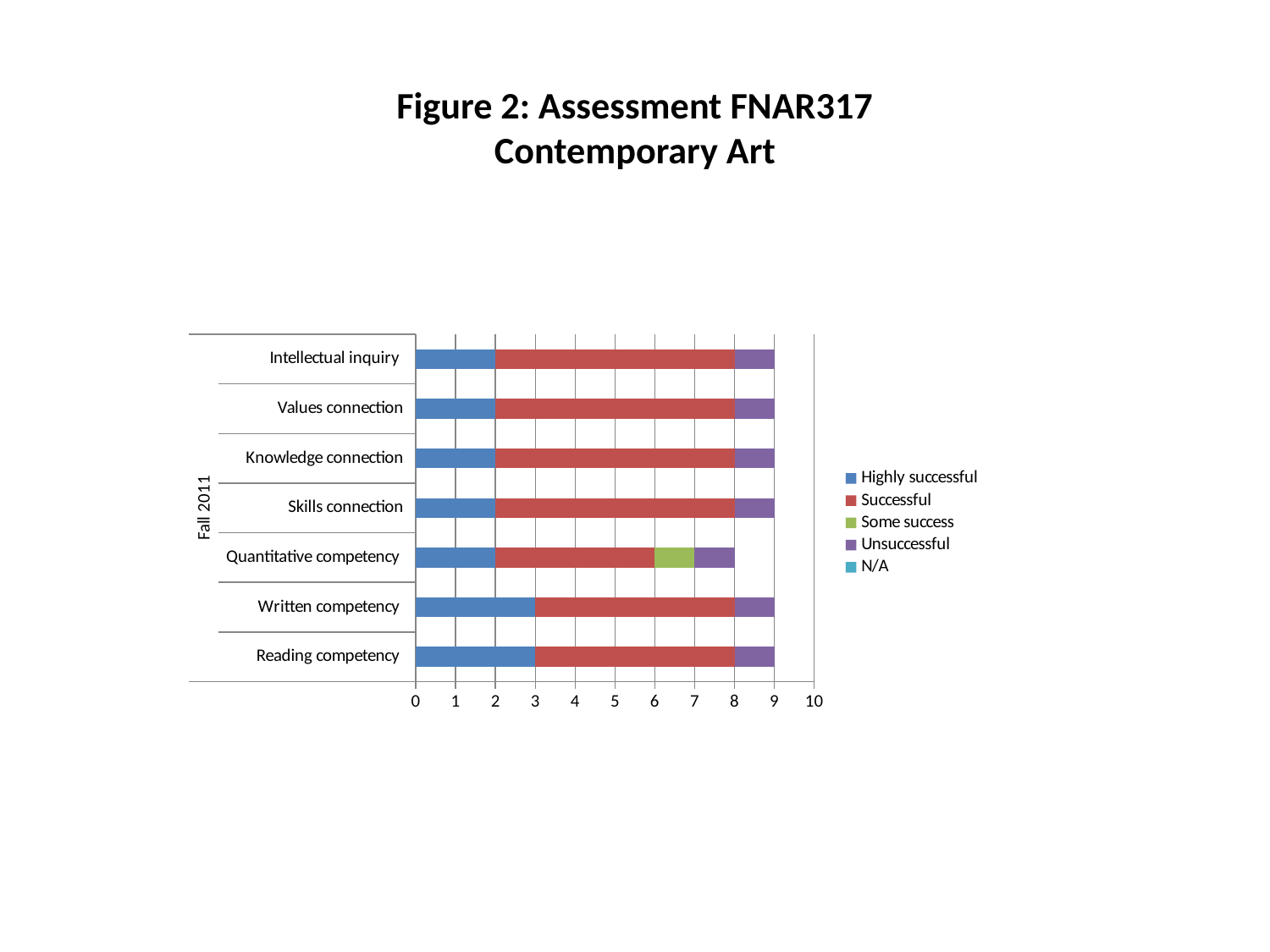
What is the Successful value for Intellectual inquiry? 6 What is the total of the stacked bar for Reading competency? 9 What kind of chart is shown on the slide? Stacked bar chart Which category has the lowest stacked bar total? Quantitative competency What is the Some success value for Quantitative competency? 1 What is the difference between the Successful value for Knowledge connection and the Successful value for Quantitative competency? 2 Which is larger, the Highly successful value for Reading competency or for Skills connection? Reading competency How many categories are listed on the vertical axis of the chart? 7 What is the total of the stacked bar for Quantitative competency? 8 What is the Highly successful value for Written competency? 3 What is the title of the chart? Figure 2: Assessment FNAR317 Contemporary Art How many series does the legend list? 5